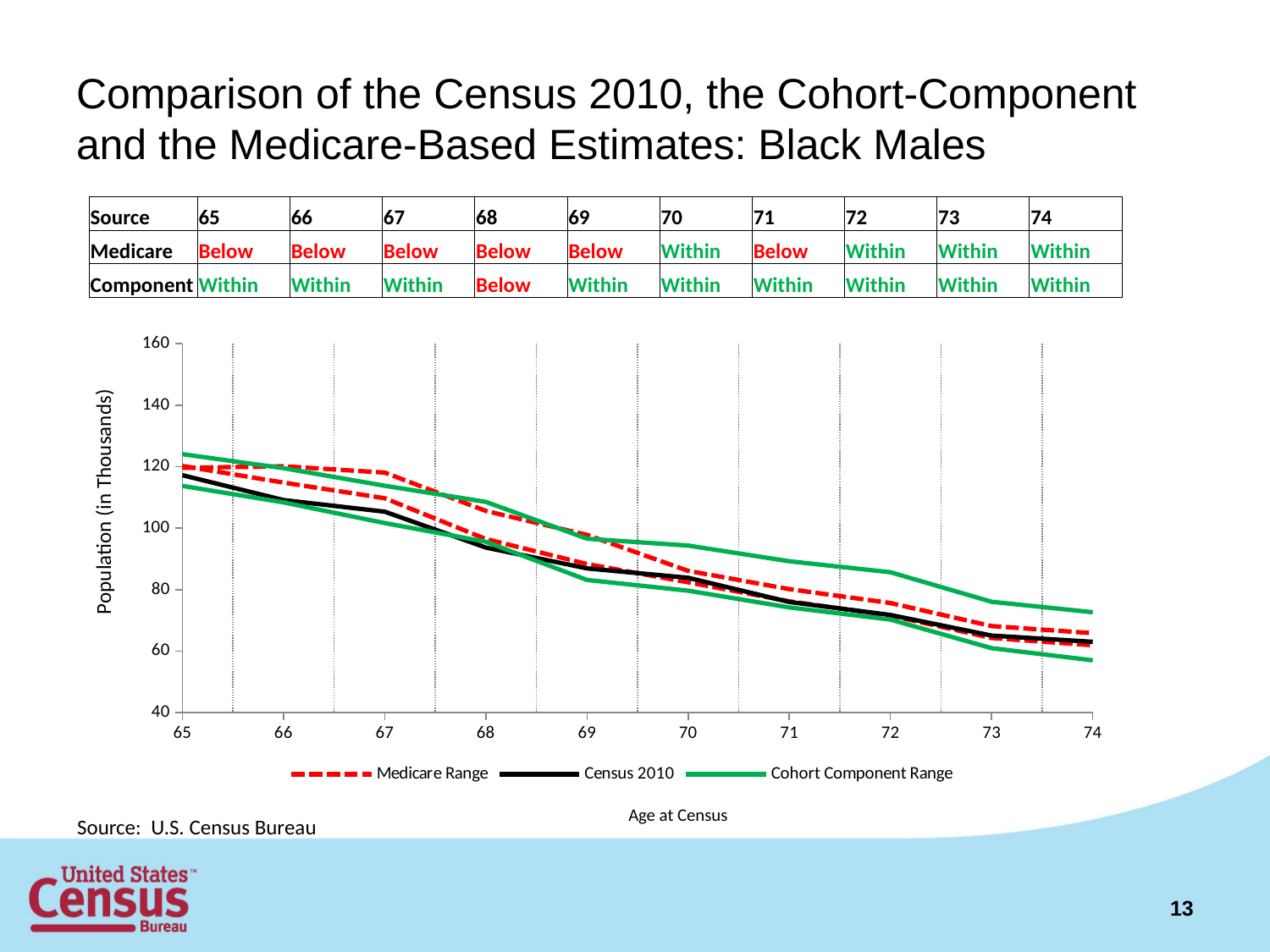
What is the title of the chart's y axis? Population (in Thousands) How many series does the chart legend list? 3 Which series in the legend is drawn as a red dashed line? Medicare Range Is the Census 2010 value at age 74 greater or less than 80? less Is the Census 2010 value at age 70 greater or less than 100? less What kind of chart is shown on the slide? line chart At which age is the Census 2010 value highest? 65 How many ages are plotted along the x axis of the chart? 10 Does the Census 2010 line rise or fall as age increases from 65 to 74? fall Is the Census 2010 value at age 72 greater or less than 80? less